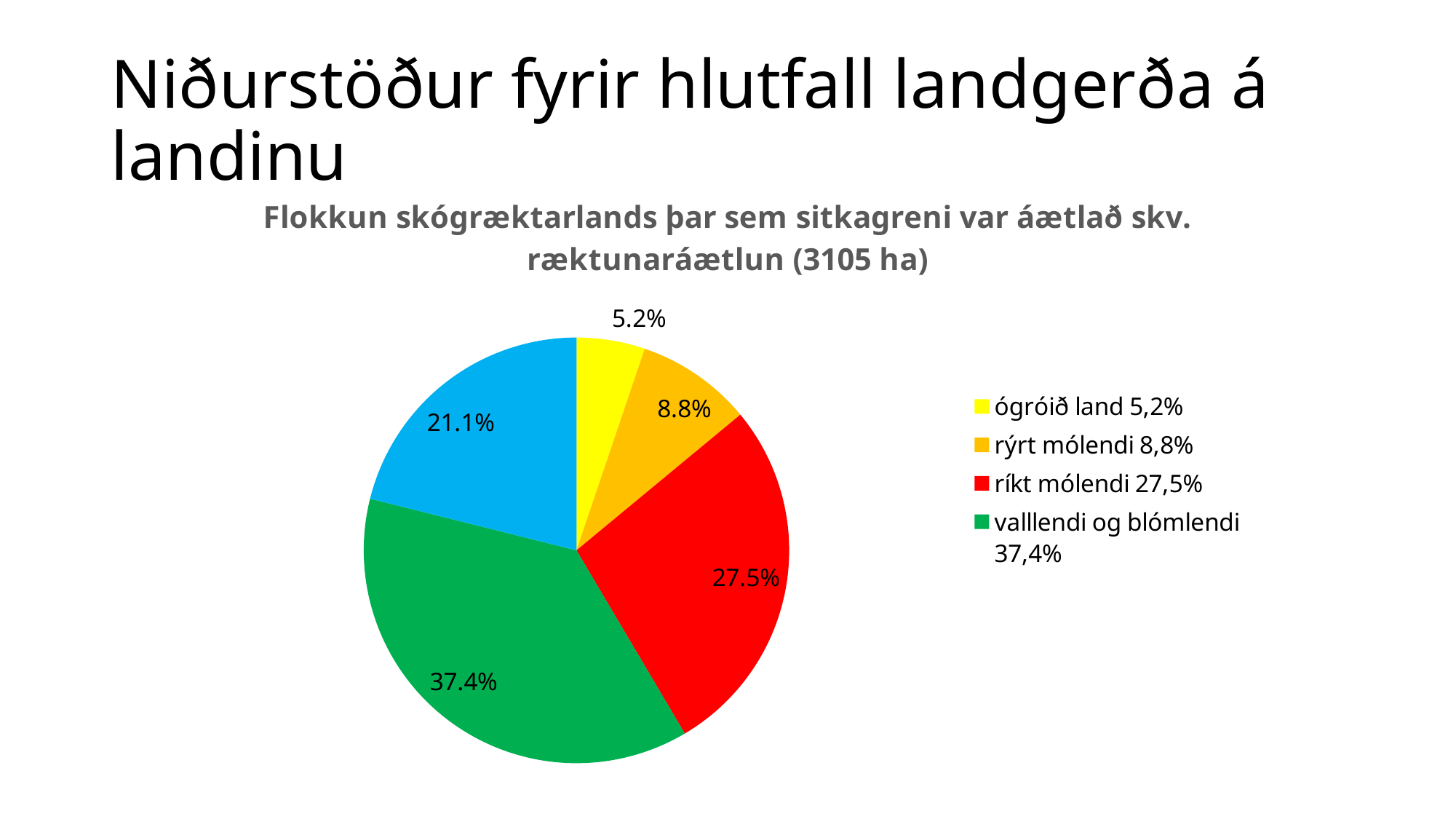
How many slices does the pie chart have? 5 What is the difference in percentage points between valllendi og blómlendi and ríkt mólendi? 9.9 How many entries does the legend list? 4 Which is larger, the slice for rýrt mólendi or the slice for ógróið land? rýrt mólendi Which category has the smallest slice of the pie? ógróið land What is the share of the pie for ríkt mólendi? 27.5% What is the share of the pie for ógróið land? 5.2% What kind of chart is shown on the slide? pie chart What colour is the slice for ríkt mólendi? red What is the share of the pie for rýrt mólendi? 8.8% Which category has the largest slice of the pie? valllendi og blómlendi What is the share of the pie for valllendi og blómlendi? 37.4%